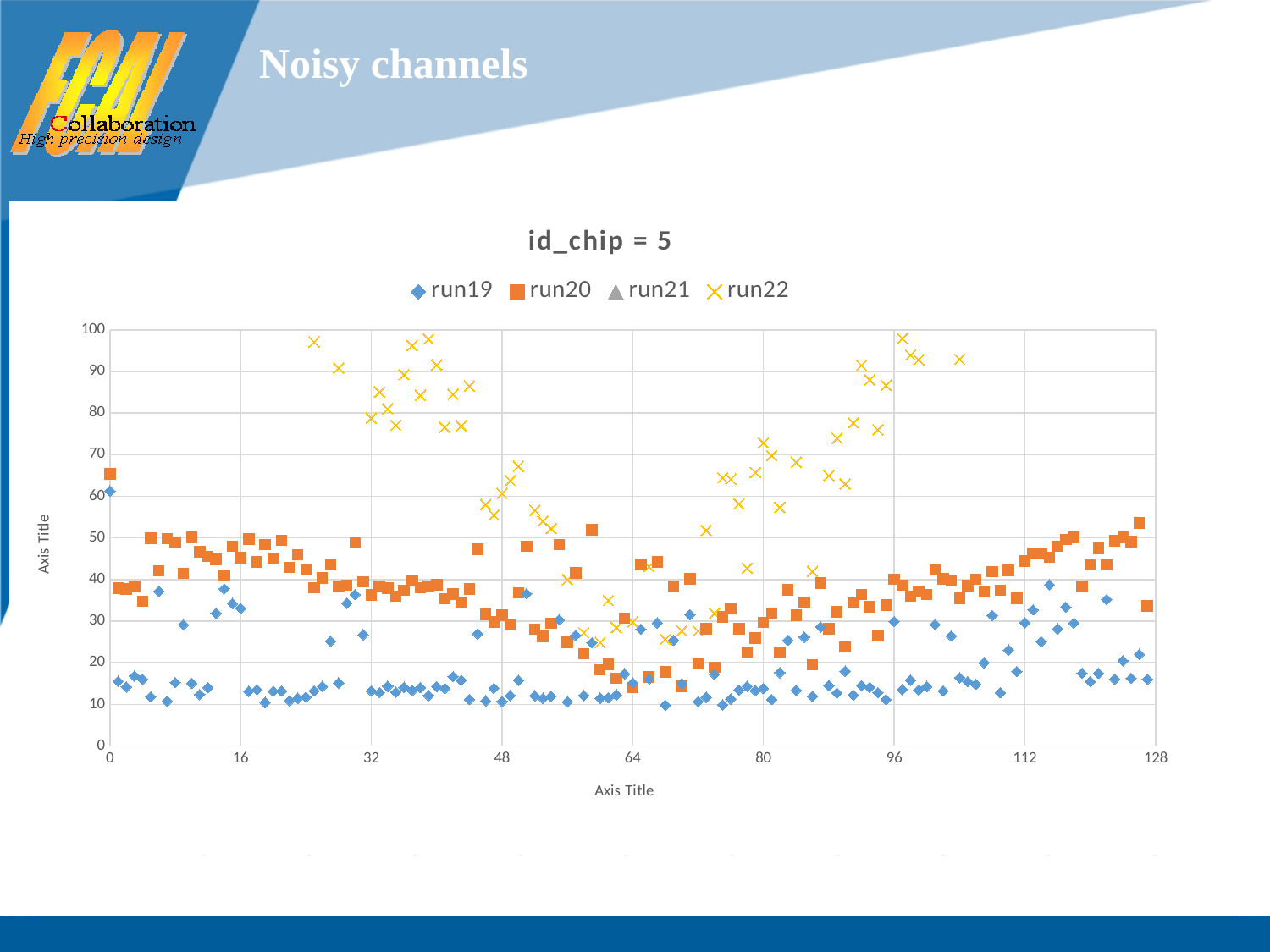
Which series reaches higher values overall, run20 or run22? run22 Is the highest run22 value greater or less than 90? greater Which series has the lowest values overall, run19 or run20? run19 Which series are listed in the chart legend? run19, run20, run21, run22 Is the run19 value at x = 0 greater or less than 50? greater How many series does the legend list? 4 What is the maximum value shown on the x axis? 128 What is the title of the chart? id_chip = 5 Is the run20 value at x = 0 greater or less than 60? greater What kind of chart is shown on the slide? scatter chart What is the maximum value shown on the y axis? 100